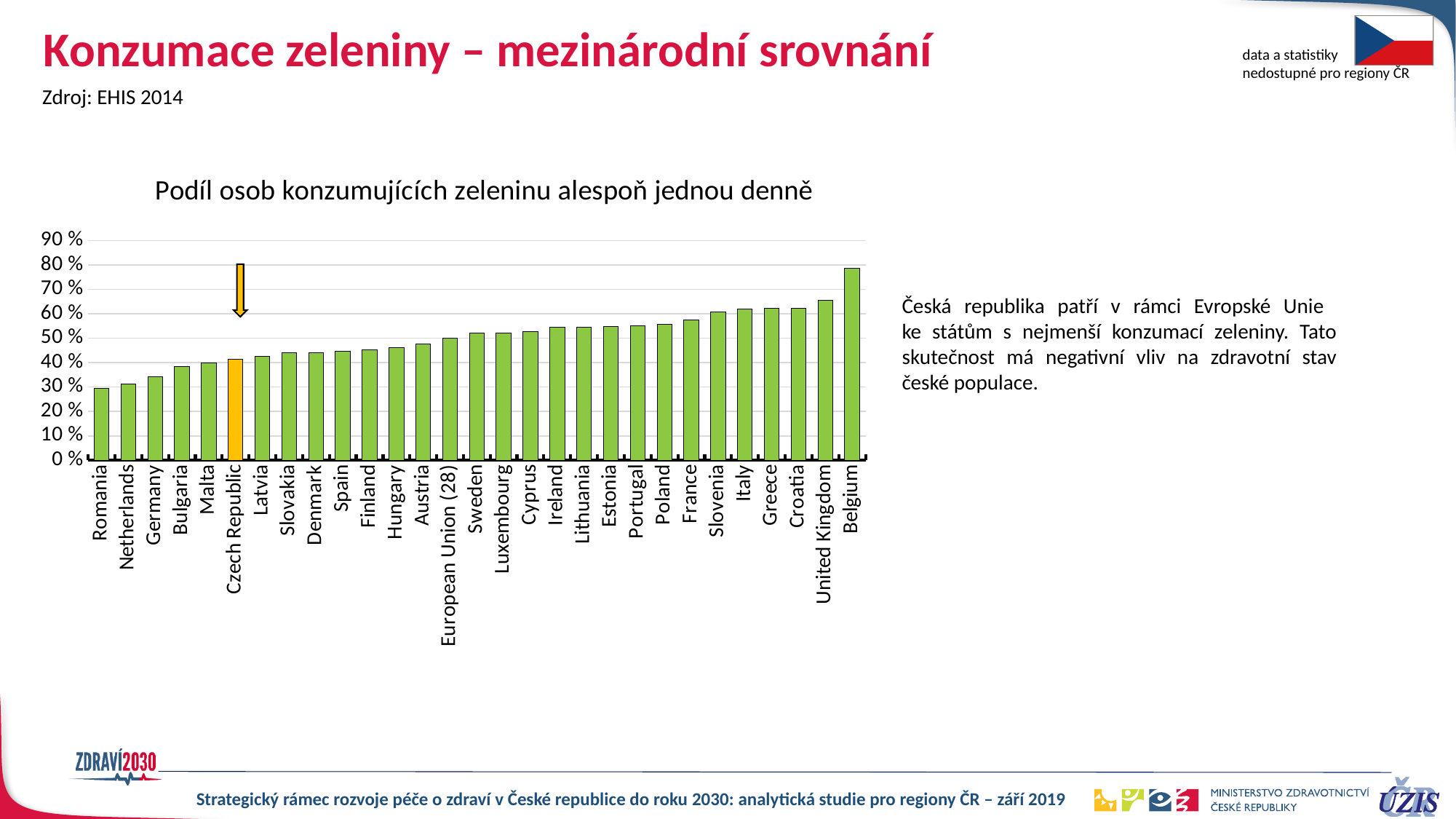
How many categories (bars) are plotted in the chart? 29 Is the value for Belgium greater or less than 70 %? greater Which country has the lowest share of people consuming vegetables at least once a day? Romania Which is larger, the value for Netherlands or the value for France? France Do the values rise or fall from left to right along the x axis? rise Which is larger, the value for Czech Republic or the value for Italy? Italy Is the value for United Kingdom greater or less than 60 %? greater Is the value for Germany greater or less than 40 %? less What kind of chart is shown on the slide? bar chart Which country's bar is highlighted in a different colour (orange) from the others? Czech Republic Which country has the highest share of people consuming vegetables at least once a day? Belgium